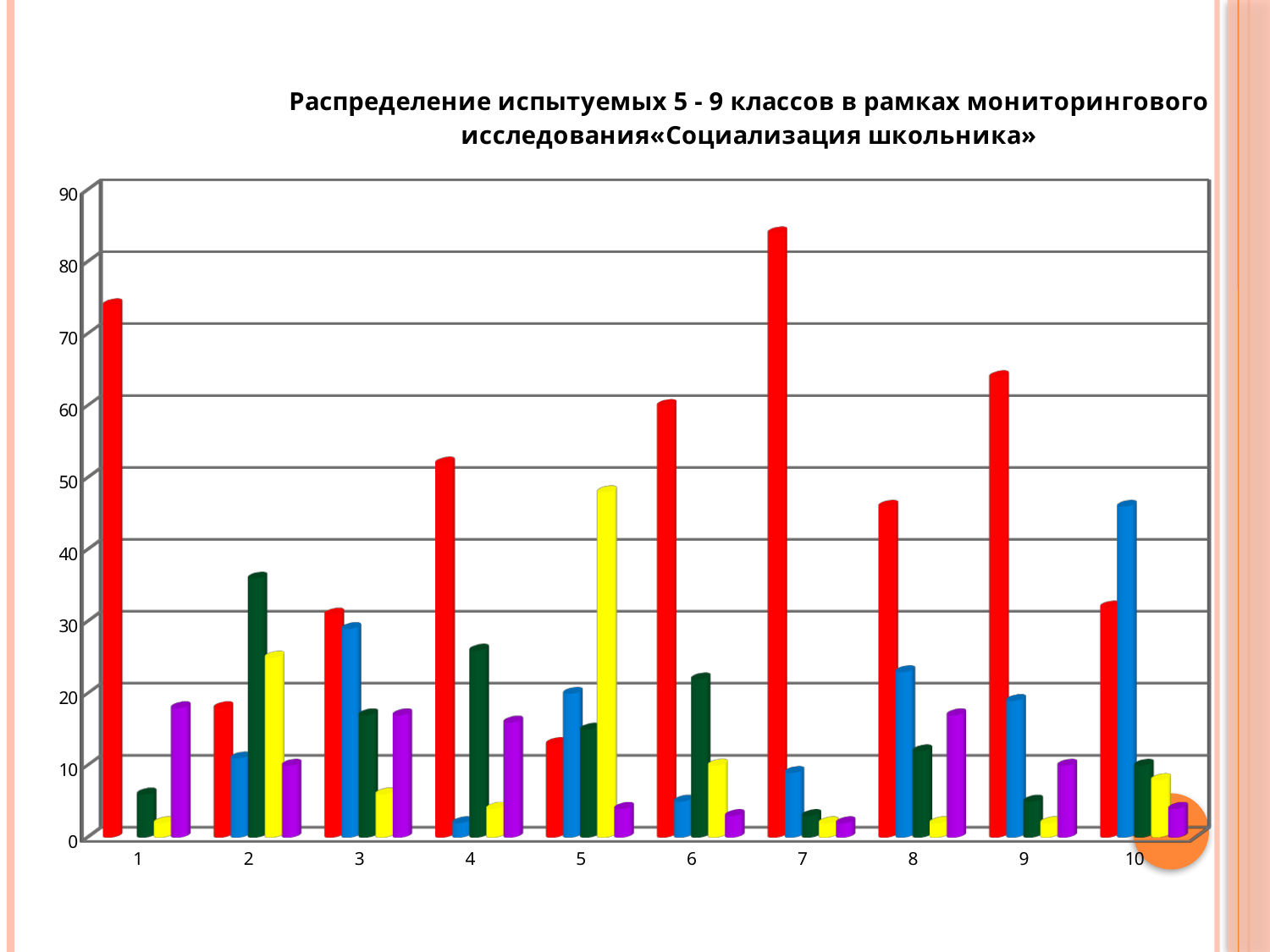
Which is larger, the red bar for category 1 or the red bar for category 9? category 1 Is the red bar for category 1 greater or less than 70? greater Which category has the tallest red bar? 7 Is the red bar for category 7 greater or less than 80? greater How many bars are plotted for each category? 5 How many categories are shown along the x axis? 10 What kind of chart is shown on the slide? bar chart Is the yellow bar for category 5 greater or less than 40? greater What is the highest value shown on the vertical axis? 90 Which category has the shortest red bar? 5